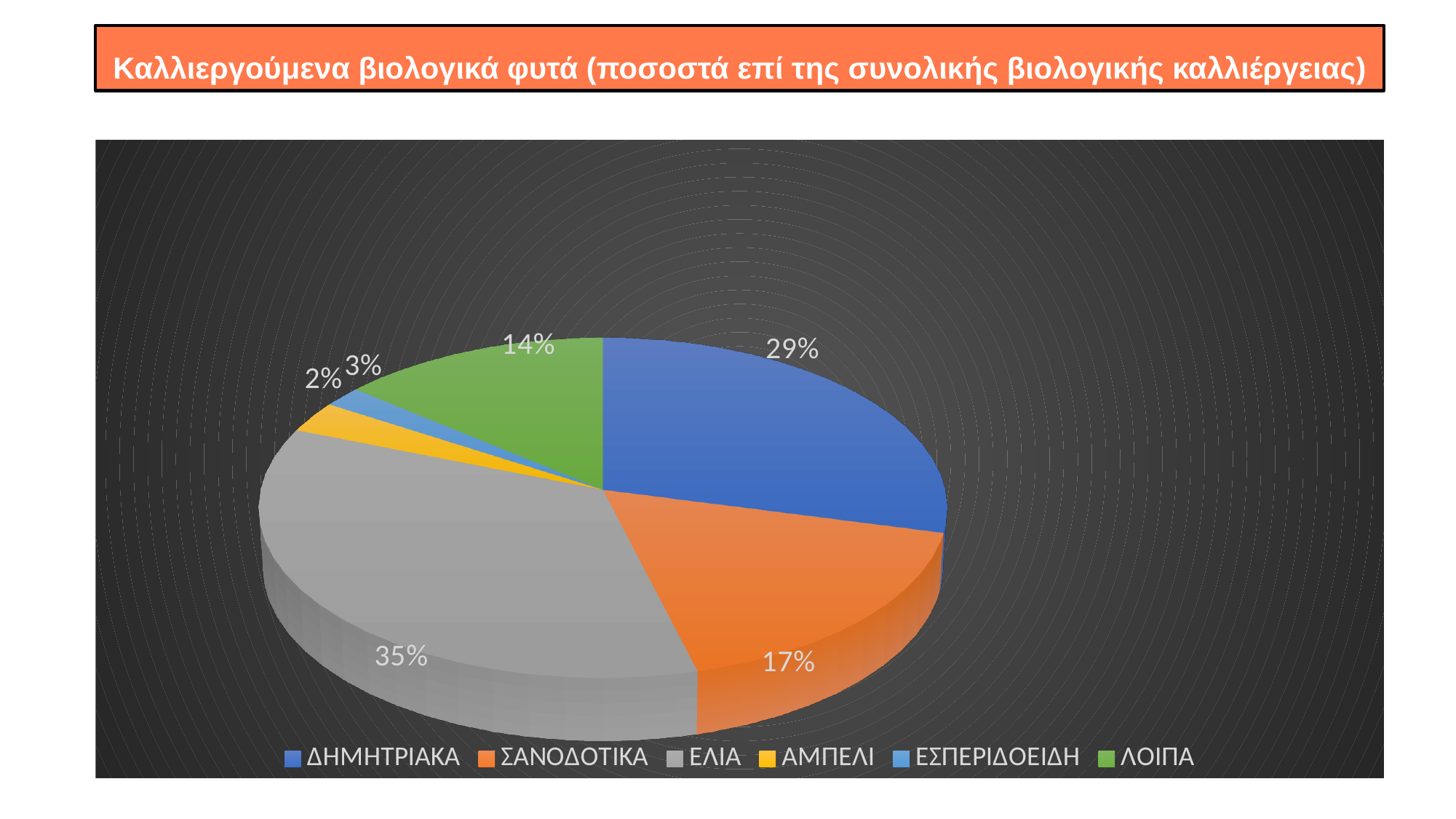
What is the value for ΛΟΙΠΑ? 14% Which is larger, the share for ΣΑΝΟΔΟΤΙΚΑ or the share for ΛΟΙΠΑ? ΣΑΝΟΔΟΤΙΚΑ What is the difference in percentage points between ΕΛΙΑ and ΔΗΜΗΤΡΙΑΚΑ? 6 What is the value shown for ΔΗΜΗΤΡΙΑΚΑ? 29% What kind of chart is shown on the slide? Pie chart Which category has the largest share of the pie? ΕΛΙΑ What percentage is shown for ΑΜΠΕΛΙ? 3% Which category has the smallest share of the pie? ΕΣΠΕΡΙΔΟΕΙΔΗ What colour is the slice for ΛΟΙΠΑ? Green What percentage of the pie does ΕΛΙΑ represent? 35% What percentage is shown for ΣΑΝΟΔΟΤΙΚΑ? 17% How many categories does the pie chart show? 6